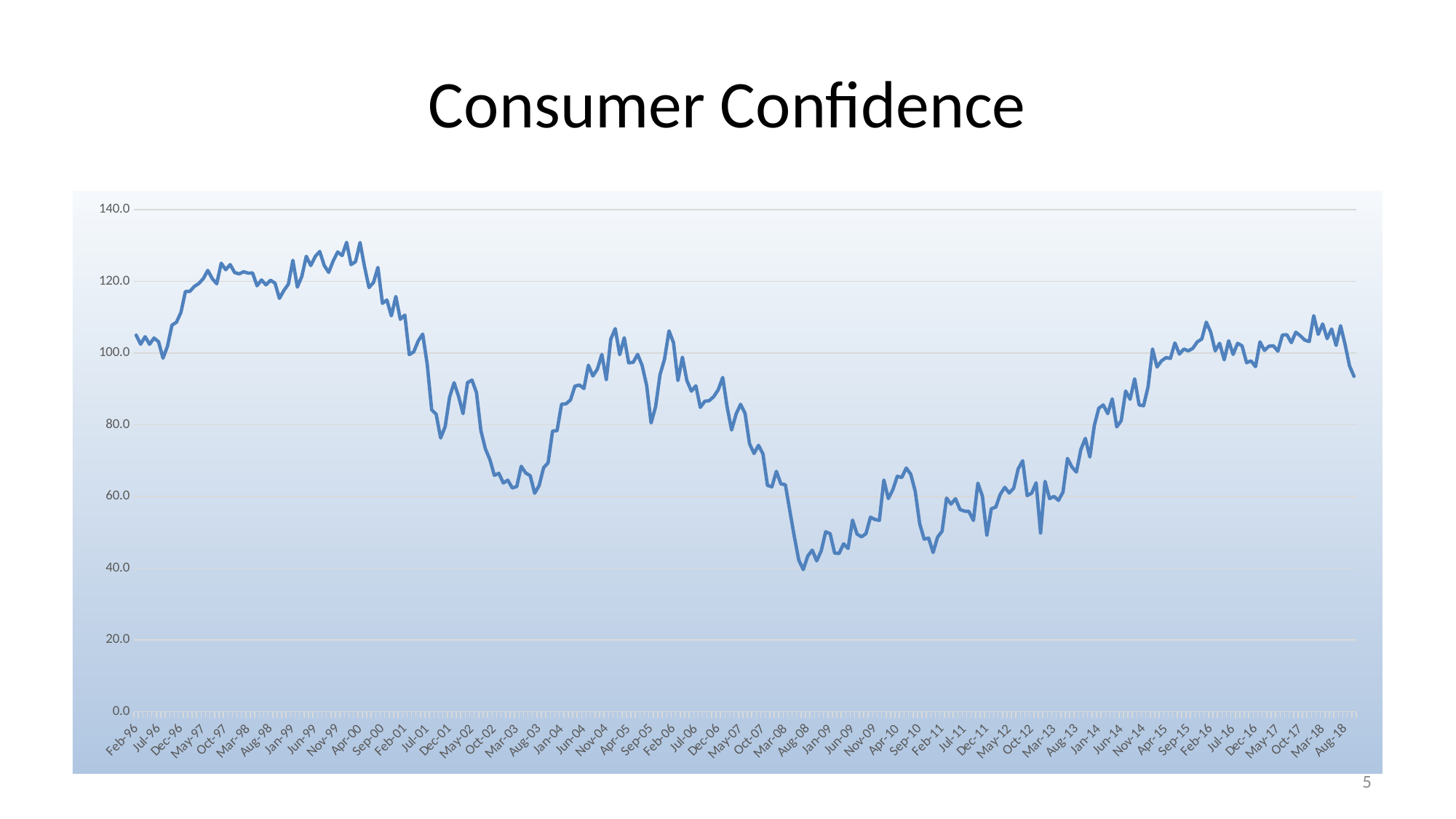
What is the title of the chart? Consumer Confidence Is the value for Feb-96 greater or less than 100? greater Do the values rise or fall between Apr-00 and Mar-03? fall What kind of chart is shown on the slide? line chart Is the value for Jan-09 greater or less than 60? less Is the value for Apr-00 greater or less than 120? greater Near which labelled date does the line reach its lowest point? Aug-08 Do the values rise or fall between Mar-13 and Feb-16? rise What is the highest value shown on the vertical axis? 140.0